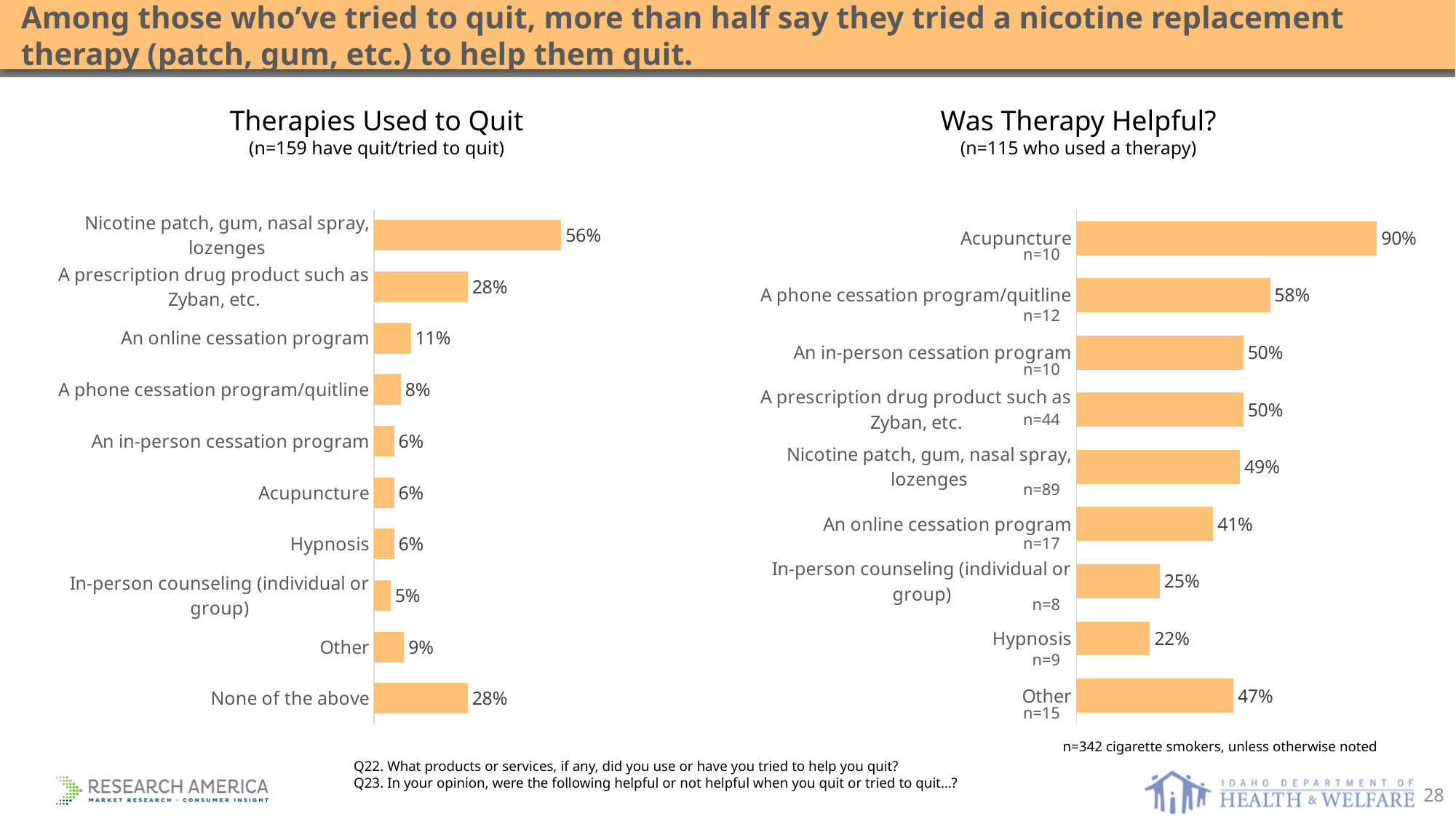
In the 'Was Therapy Helpful?' chart, which therapy has the lowest percentage? Hypnosis In the 'Therapies Used to Quit' chart, how many categories are shown? 10 In the 'Was Therapy Helpful?' chart, what is the difference between the acupuncture value and the 'Other' value? 43% What type of chart is the 'Was Therapy Helpful?' chart? Bar chart In the 'Therapies Used to Quit' chart, which category has the lowest percentage? In-person counseling (individual or group) In the 'Therapies Used to Quit' chart, which therapy has the highest percentage? Nicotine patch, gum, nasal spray, lozenges In the 'Therapies Used to Quit' chart, what percentage used an online cessation program? 11% In the 'Was Therapy Helpful?' chart, what percentage found acupuncture helpful? 90% In the 'Was Therapy Helpful?' chart, what percentage found hypnosis helpful? 22% In the 'Therapies Used to Quit' chart, what percentage used nicotine patch, gum, nasal spray, lozenges? 56% In the 'Therapies Used to Quit' chart, what is the difference between the nicotine patch, gum, nasal spray, lozenges value and the prescription drug product value? 28% In the 'Was Therapy Helpful?' chart, which is larger: the value for a phone cessation program/quitline or the value for an online cessation program? A phone cessation program/quitline